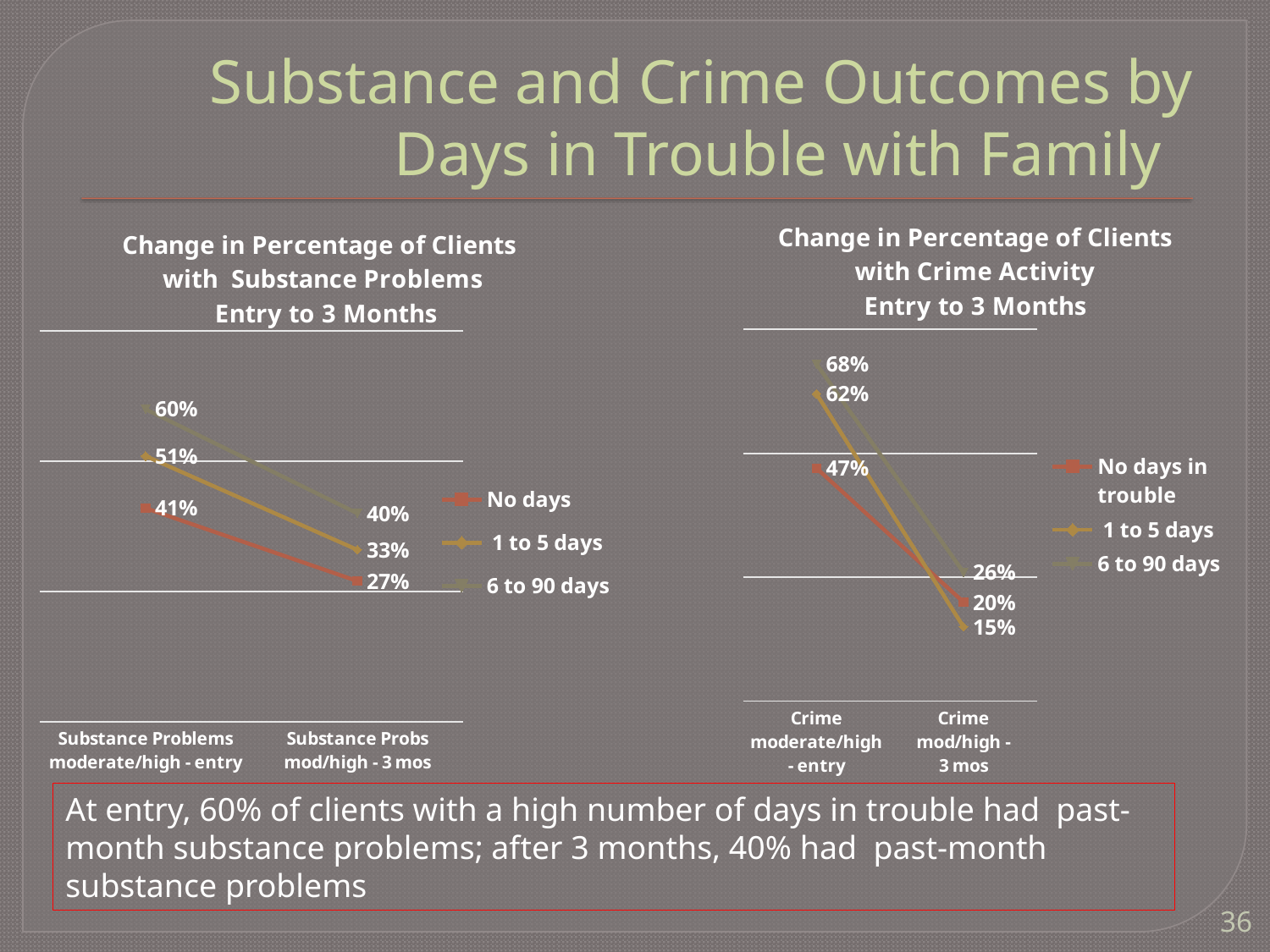
In the 'Change in Percentage of Clients with Substance Problems' chart, what is the difference between the '1 to 5 days' values at entry and at 3 months? 18% In the 'Change in Percentage of Clients with Substance Problems' chart, how many series does the legend list? 3 In the 'Change in Percentage of Clients with Substance Problems' chart, what is the value for the 'No days' series at 'Substance Probs mod/high - 3 mos'? 27% In the 'Change in Percentage of Clients with Substance Problems' chart, which series has the highest value at entry? 6 to 90 days In the 'Change in Percentage of Clients with Crime Activity' chart, what is the difference between the 'No days in trouble' values at entry and at 3 months? 27% What kind of chart is the 'Change in Percentage of Clients with Crime Activity' chart? line chart In the 'Change in Percentage of Clients with Crime Activity' chart, which is larger at 3 months: 'No days in trouble' or '6 to 90 days'? 6 to 90 days In the 'Change in Percentage of Clients with Crime Activity' chart, what is the value for the '6 to 90 days' series at 'Crime mod/high - 3 mos'? 26% In the 'Change in Percentage of Clients with Substance Problems' chart, what is the value for the '6 to 90 days' series at 'Substance Problems moderate/high - entry'? 60% In the 'Change in Percentage of Clients with Crime Activity' chart, which series has the lowest value at 3 months? 1 to 5 days In the 'Change in Percentage of Clients with Substance Problems' chart, do the values rise or fall from entry to 3 months? fall In the 'Change in Percentage of Clients with Crime Activity' chart, what is the value for the '1 to 5 days' series at 'Crime moderate/high - entry'? 62%